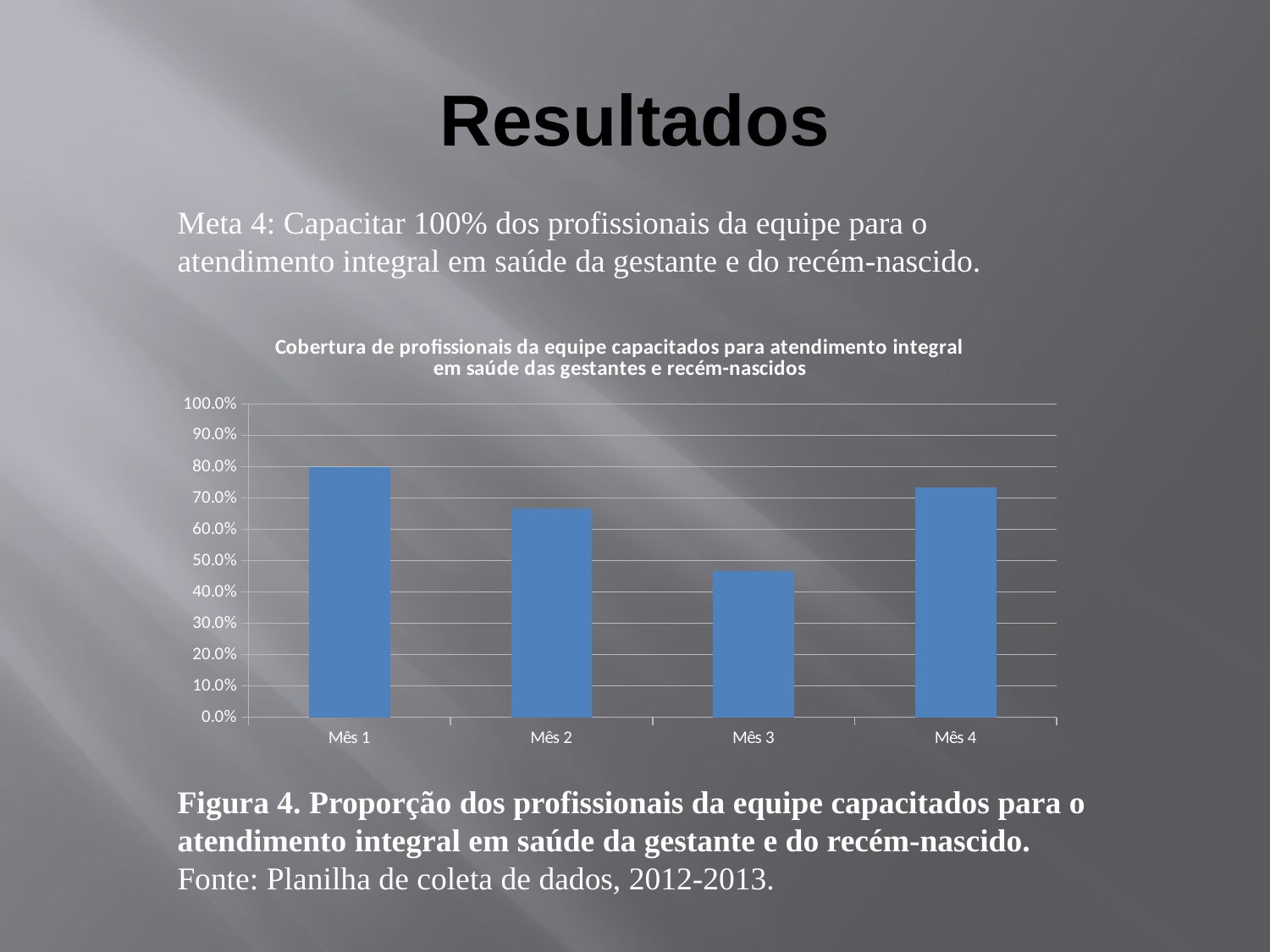
Is the value for Mês 3 greater or less than 50.0%? less Which month has the highest value in the chart? Mês 1 What is the title of the chart? Cobertura de profissionais da equipe capacitados para atendimento integral em saúde das gestantes e recém-nascidos What kind of chart is shown on the slide? bar chart Is the value for Mês 4 greater or less than 70.0%? greater Does the value rise or fall from Mês 2 to Mês 3? fall Which has the larger value, Mês 2 or Mês 4? Mês 4 How many categories (months) are shown on the x axis of the chart? 4 Is the value for Mês 2 greater or less than 60.0%? greater Which has the larger value, Mês 1 or Mês 3? Mês 1 Which month has the lowest value in the chart? Mês 3